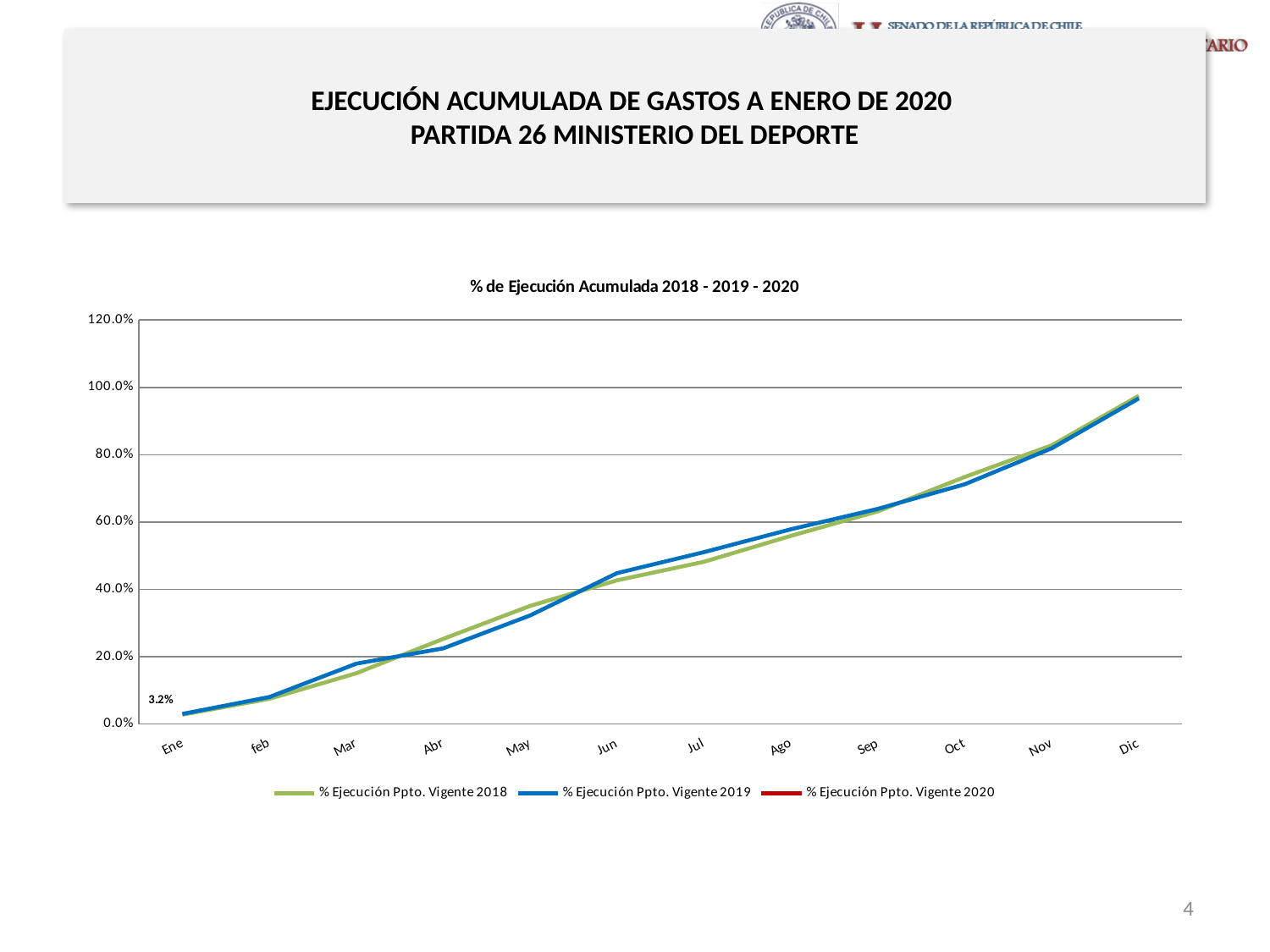
What kind of chart is shown on the slide? line chart What is the title of the chart? % de Ejecución Acumulada 2018 - 2019 - 2020 Is the value for % Ejecución Ppto. Vigente 2018 in Jun greater or less than 60.0%? less Do the values for % Ejecución Ppto. Vigente 2019 rise or fall from Ene to Dic? rise In which month is the value for % Ejecución Ppto. Vigente 2019 highest? Dic Is the value for % Ejecución Ppto. Vigente 2018 in Sep greater or less than 40.0%? greater How many series does the legend list? 3 Which series is drawn in blue? % Ejecución Ppto. Vigente 2019 In which month is the value for % Ejecución Ppto. Vigente 2018 lowest? Ene What value is printed as a data label at Ene? 3.2% How many months are shown on the x axis? 12 Is the value for % Ejecución Ppto. Vigente 2019 in Dic greater or less than 80.0%? greater